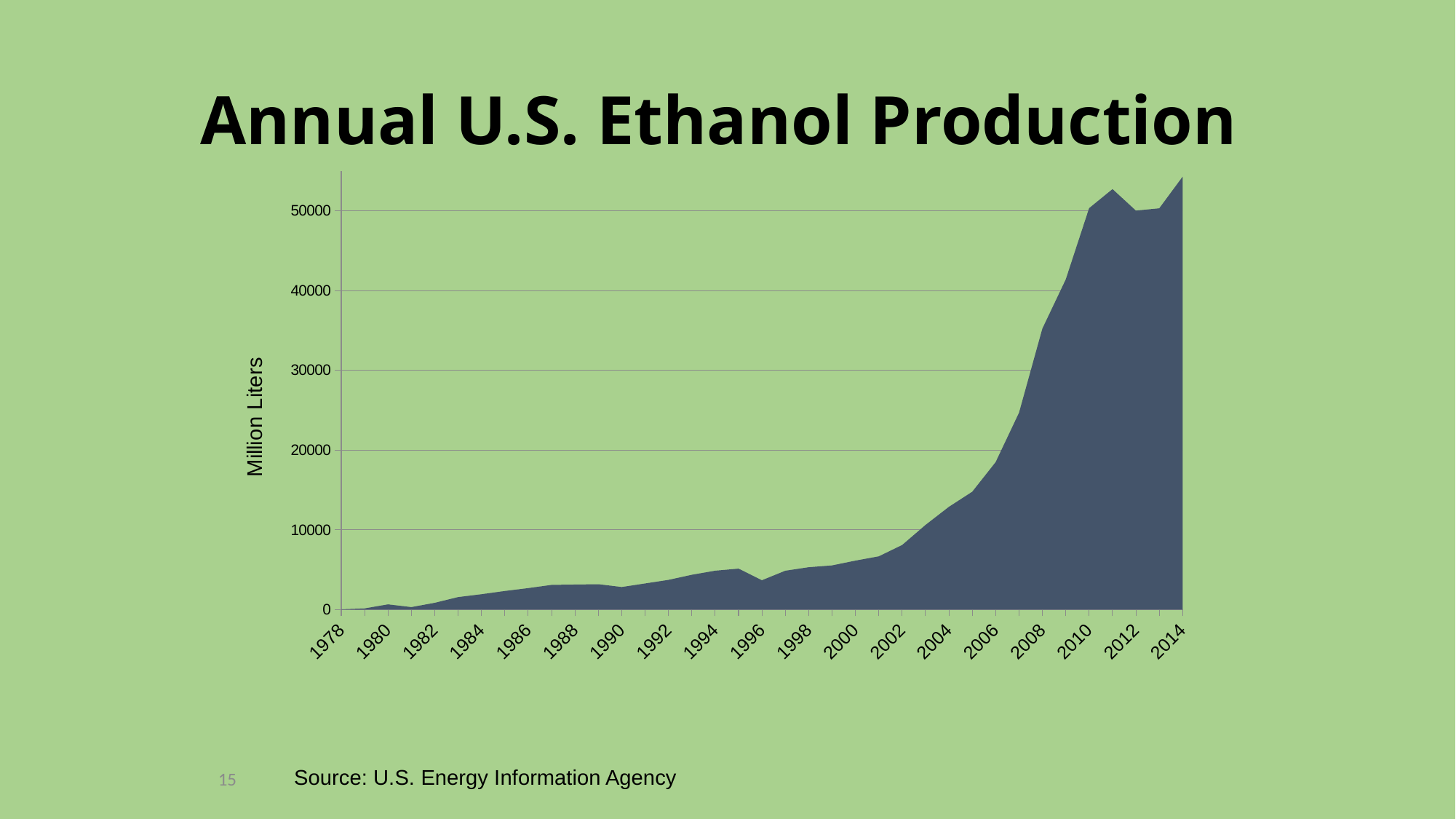
What is the title of the chart? Annual U.S. Ethanol Production How many year labels are shown on the horizontal axis? 19 Is the value for 2010 greater or less than 40000? greater Is the value for 2008 greater or less than 30000? greater What kind of chart is shown on the slide? area chart What is the label on the vertical axis? Million Liters Overall, do the values rise or fall from 1978 to 2014? rise Which year has a larger value, 2000 or 2010? 2010 Is the value for 2002 greater or less than 10000? less Which year has a larger value, 1990 or 2006? 2006